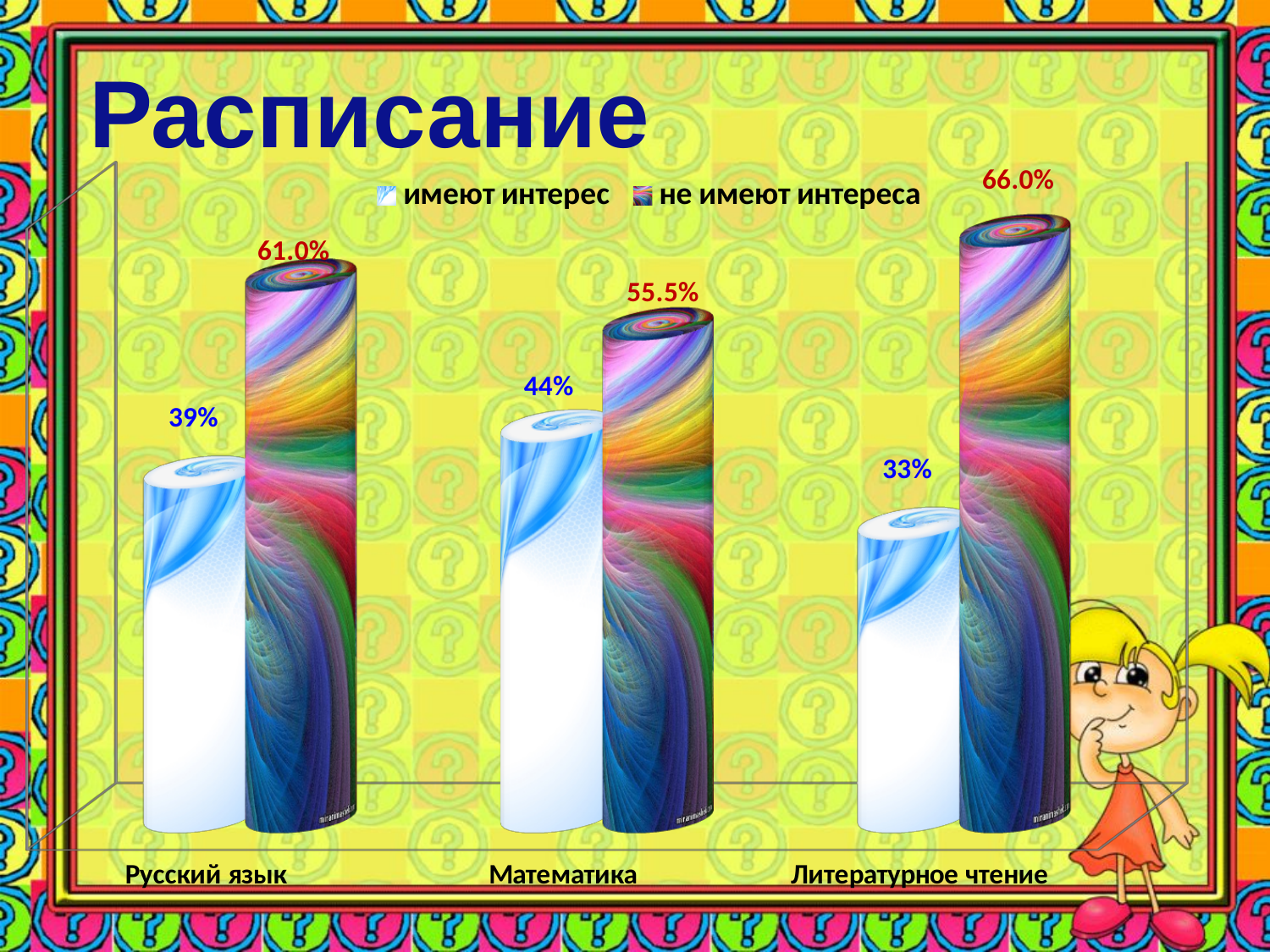
What is the difference between the "не имеют интереса" and "имеют интерес" values for Русский язык? 22% What is the value for "имеют интерес" for Математика? 44% What is the value for "не имеют интереса" for Математика? 55.5% Which category has the highest value for "не имеют интереса"? Литературное чтение What kind of chart is shown on the slide? bar chart How many categories are shown on the x axis? 3 Which is larger for Математика: "имеют интерес" or "не имеют интереса"? не имеют интереса How many series does the legend list? 2 What is the value for "имеют интерес" for Русский язык? 39% Which category has the lowest value for "имеют интерес"? Литературное чтение Which category has the highest value for "имеют интерес"? Математика What is the value for "не имеют интереса" for Литературное чтение? 66.0%